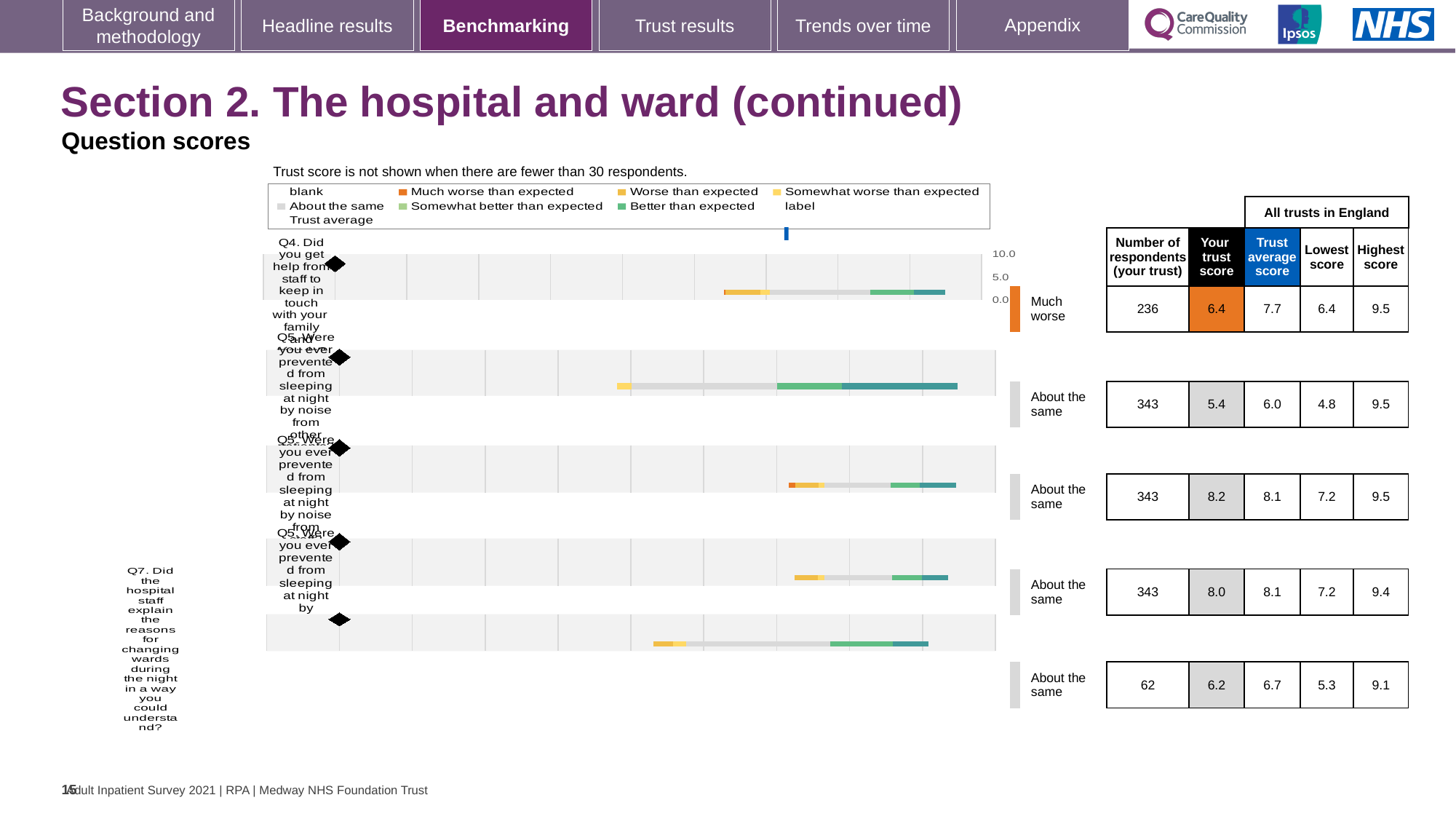
In the table, what is 'Your trust score' for Q4 (help from staff to keep in touch with family)? 6.4 What is the highest 'Your trust score' value listed in the table? 8.2 In the table, how many respondents (your trust) are listed for Q4 (help from staff to keep in touch with family)? 236 How many question rows (bars) are plotted in the chart? 5 In the table, what is the trust average score for Q4 (help from staff to keep in touch with family)? 7.7 For Q4, what is the difference between the trust average score (7.7) and your trust score (6.4)? 1.3 What is the maximum value shown on the chart's score axis? 10.0 What benchmark category label is shown next to the Q4 row? Much worse Which question row has the fewest respondents in the table? Q7 (explaining reasons for changing wards during the night) Which colour does the legend use for 'Much worse than expected'? orange For Q4, which is larger: your trust score or the trust average score? Trust average score What kind of chart is shown on the slide? bar chart